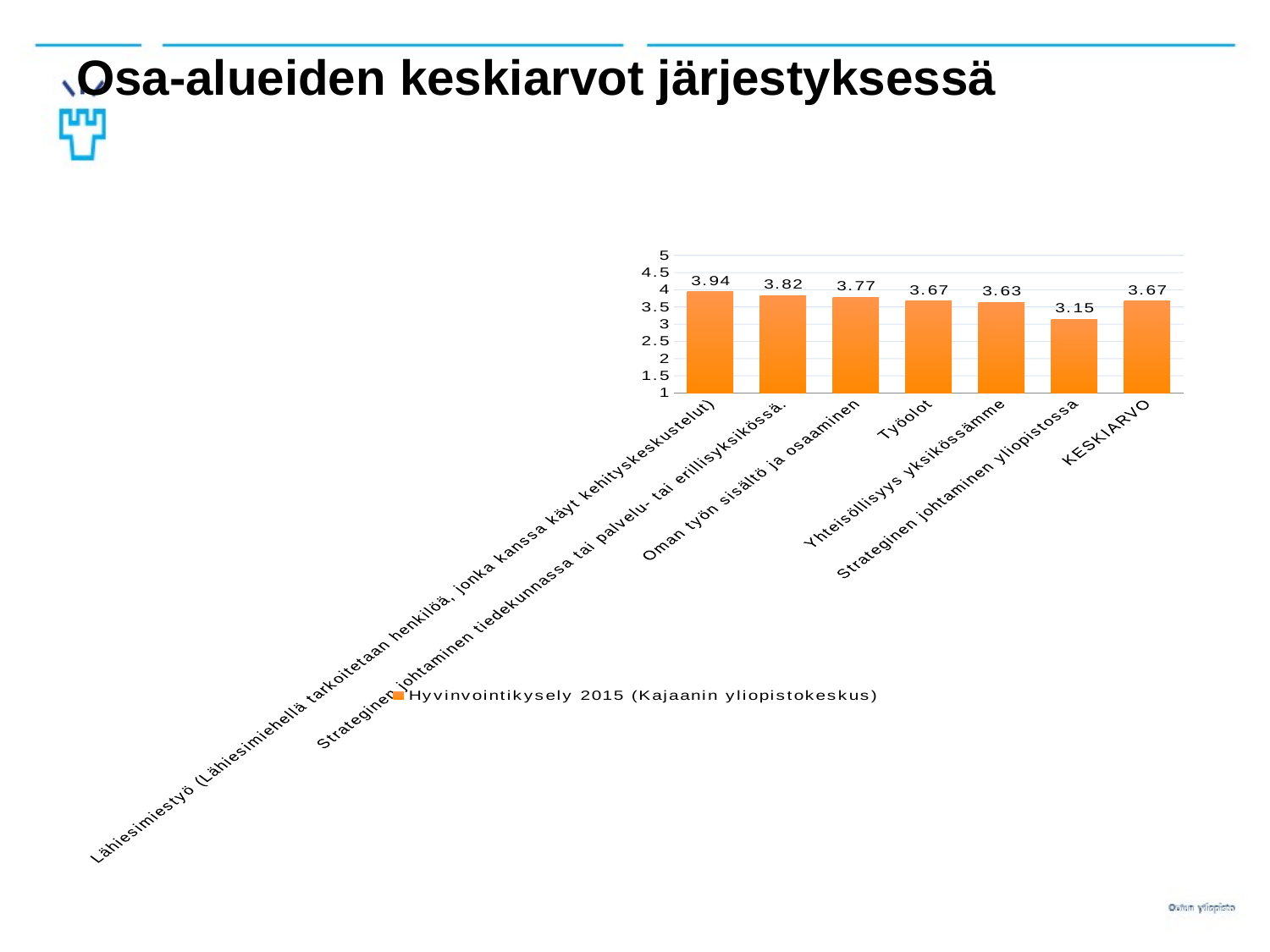
What is the difference between the values for Lähiesimiestyö and Strateginen johtaminen yliopistossa? 0.79 Is the value for Strateginen johtaminen yliopistossa greater or less than 3.5? less What is the value for Oman työn sisältö ja osaaminen? 3.77 Which category has the highest value? Lähiesimiestyö (Lähiesimiehellä tarkoitetaan henkilöä, jonka kanssa käyt kehityskeskustelut) How many bars are shown in the chart? 7 What kind of chart is shown on the slide? bar chart What is the value for Strateginen johtaminen yliopistossa? 3.15 Which category has the lowest value? Strateginen johtaminen yliopistossa Which is larger, the value for Yhteisöllisyys yksikössämme or the value for Strateginen johtaminen yliopistossa? Yhteisöllisyys yksikössämme What is the value for Työolot? 3.67 What series name does the legend show? Hyvinvointikysely 2015 (Kajaanin yliopistokeskus) What is the value for KESKIARVO? 3.67